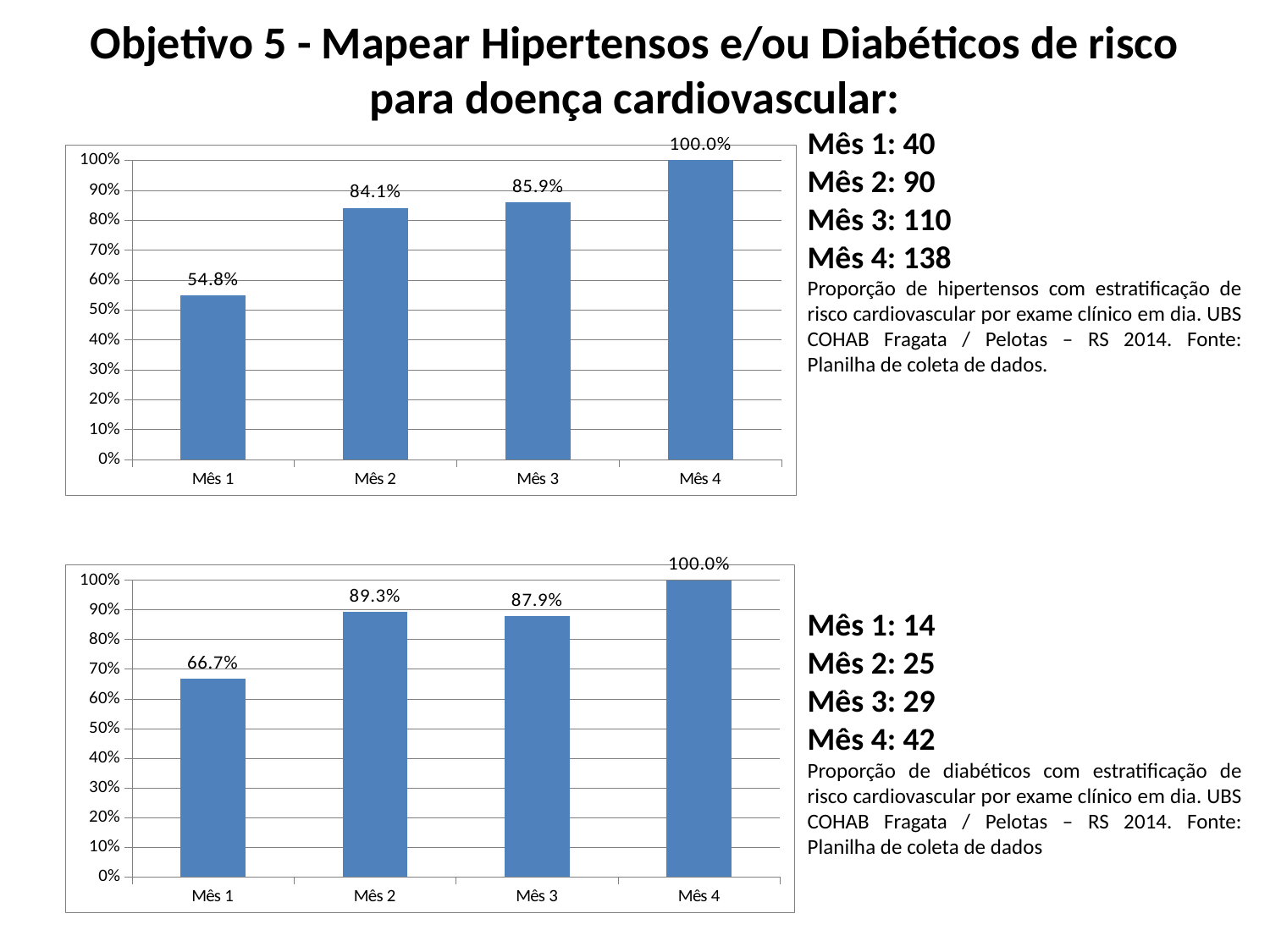
What kind of chart is the bottom chart (diabéticos)? Bar chart In the bottom chart (diabéticos), is the value for Mês 1 greater or less than 60%? greater In the top chart (hipertensos), what is the value for Mês 3? 85.9% In the bottom chart (diabéticos), which is larger, the value for Mês 2 or Mês 3? Mês 2 In the bottom chart (diabéticos), what is the value for Mês 2? 89.3% How many categories are shown on the x axis of the top chart (hipertensos)? 4 In the top chart (hipertensos), do the values rise or fall from Mês 1 to Mês 4? Rise In the top chart (hipertensos), which month has the lowest value? Mês 1 In the bottom chart (diabéticos), what is the value for Mês 1? 66.7% In the bottom chart (diabéticos), which month has the highest value? Mês 4 In the top chart (hipertensos), what is the difference between Mês 2 and Mês 1? 29.3% In the top chart (hipertensos), what is the value for Mês 1? 54.8%